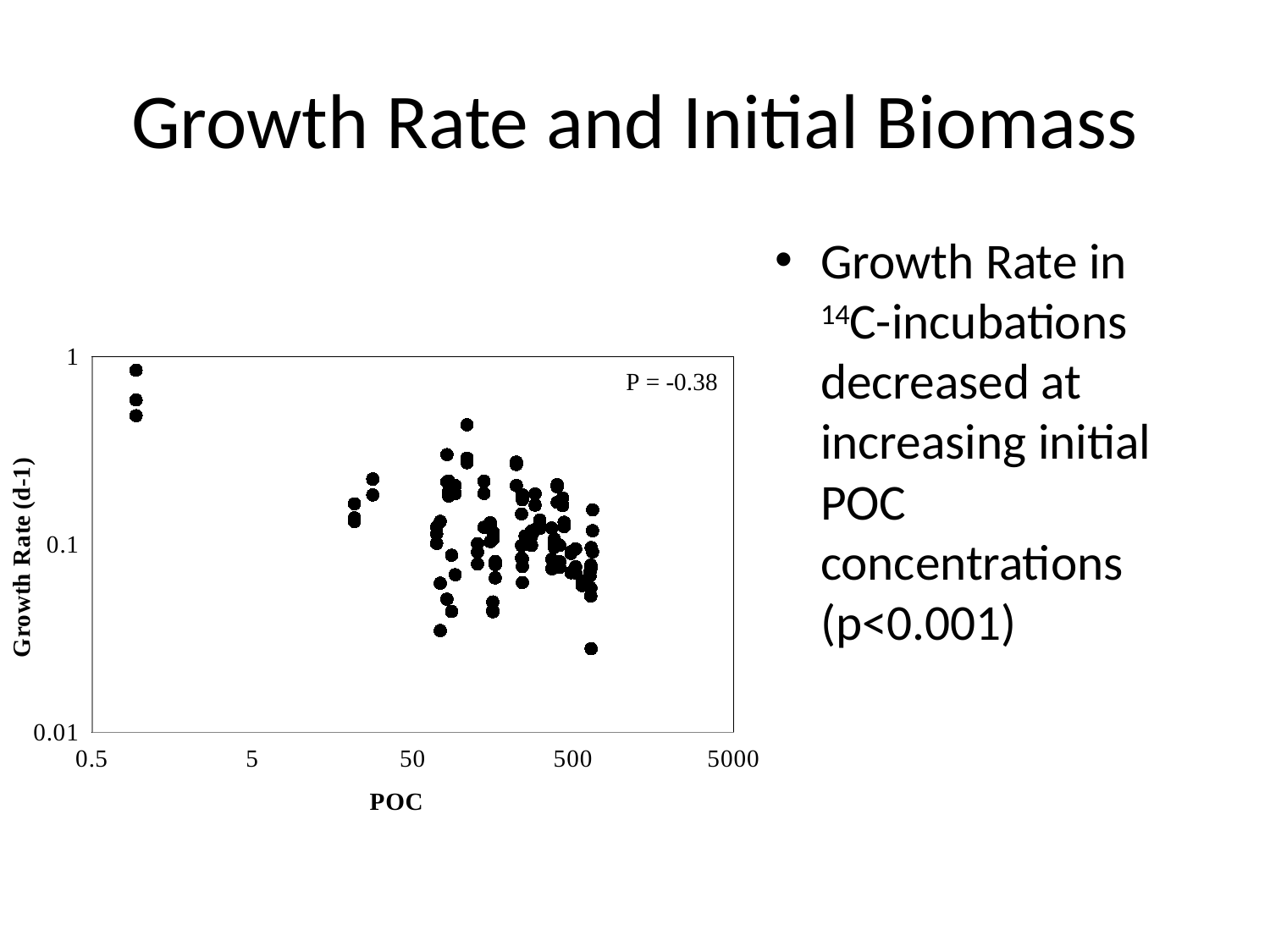
What is the smallest tick value shown on the y axis? 0.01 Is the highest point on the chart greater or less than 0.1 on the growth rate axis? greater What is the largest tick value shown on the x axis? 5000 Do the growth rate values generally rise or fall as POC increases along the x axis? fall What correlation value is printed inside the plot area? P = -0.38 What is the label of the x axis of the chart? POC Is the lowest point on the chart greater or less than 0.1 on the growth rate axis? less Are the points at the far left of the chart (POC near 1) greater or less than 0.1 on the growth rate axis? greater What kind of chart is shown on the slide? scatter plot Which group of points has higher growth rates: those at POC near 1 or those at POC near 500? those at POC near 1 What is the label of the y axis of the chart? Growth Rate (d-1)